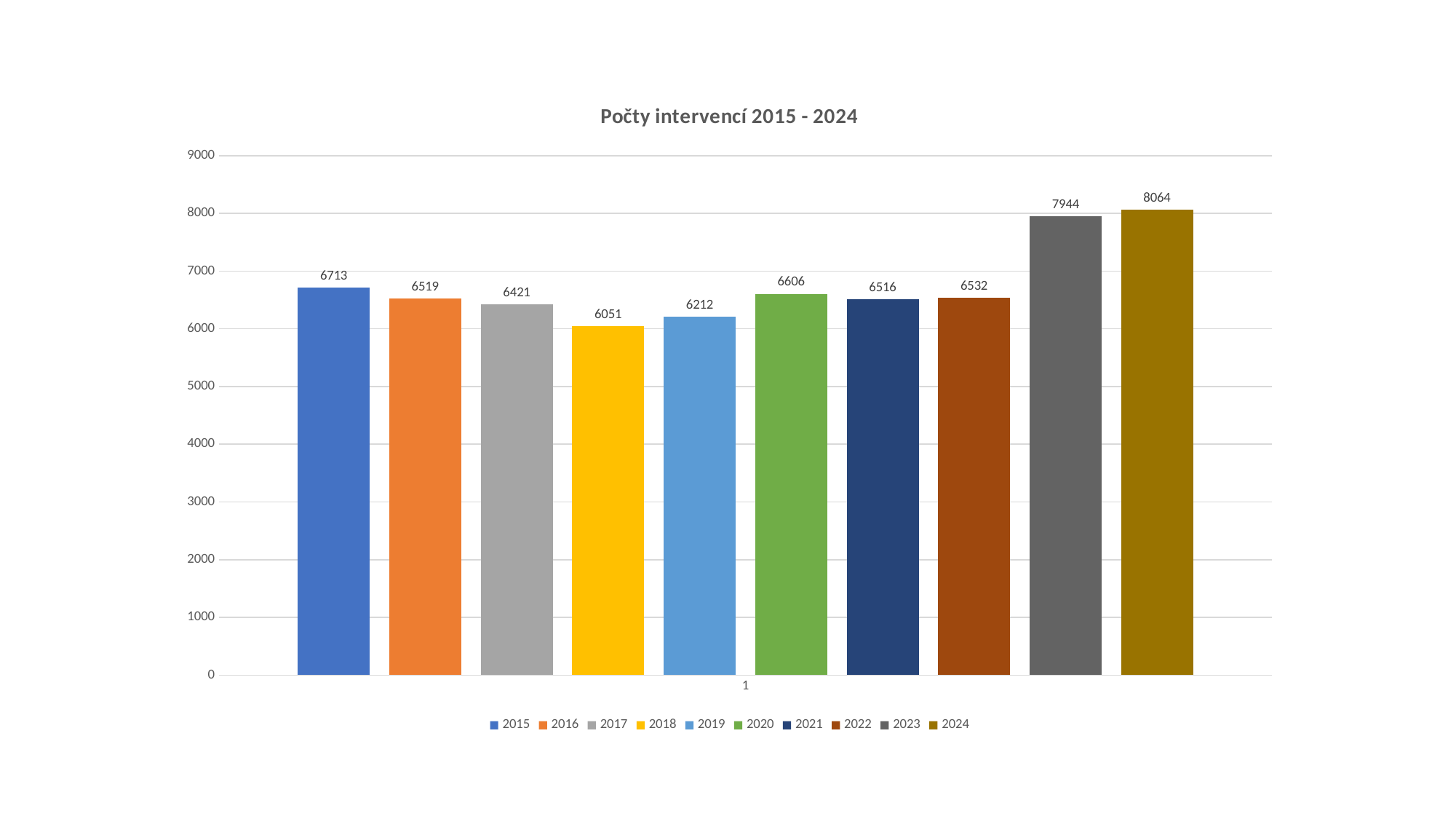
What is the value for 2018? 6051 What is the value for 2015? 6713 Which year has the highest value? 2024 Is the value for 2023 greater or less than 7000? greater What is the value for 2023? 7944 What is the title of the chart? Počty intervencí 2015 - 2024 How many series does the legend list? 10 What is the difference between the values for 2024 and 2023? 120 What kind of chart is shown on the slide? bar chart Which year has the lowest value? 2018 What is the difference between the values for 2015 and 2018? 662 Which is larger, the value for 2019 or the value for 2020? 2020